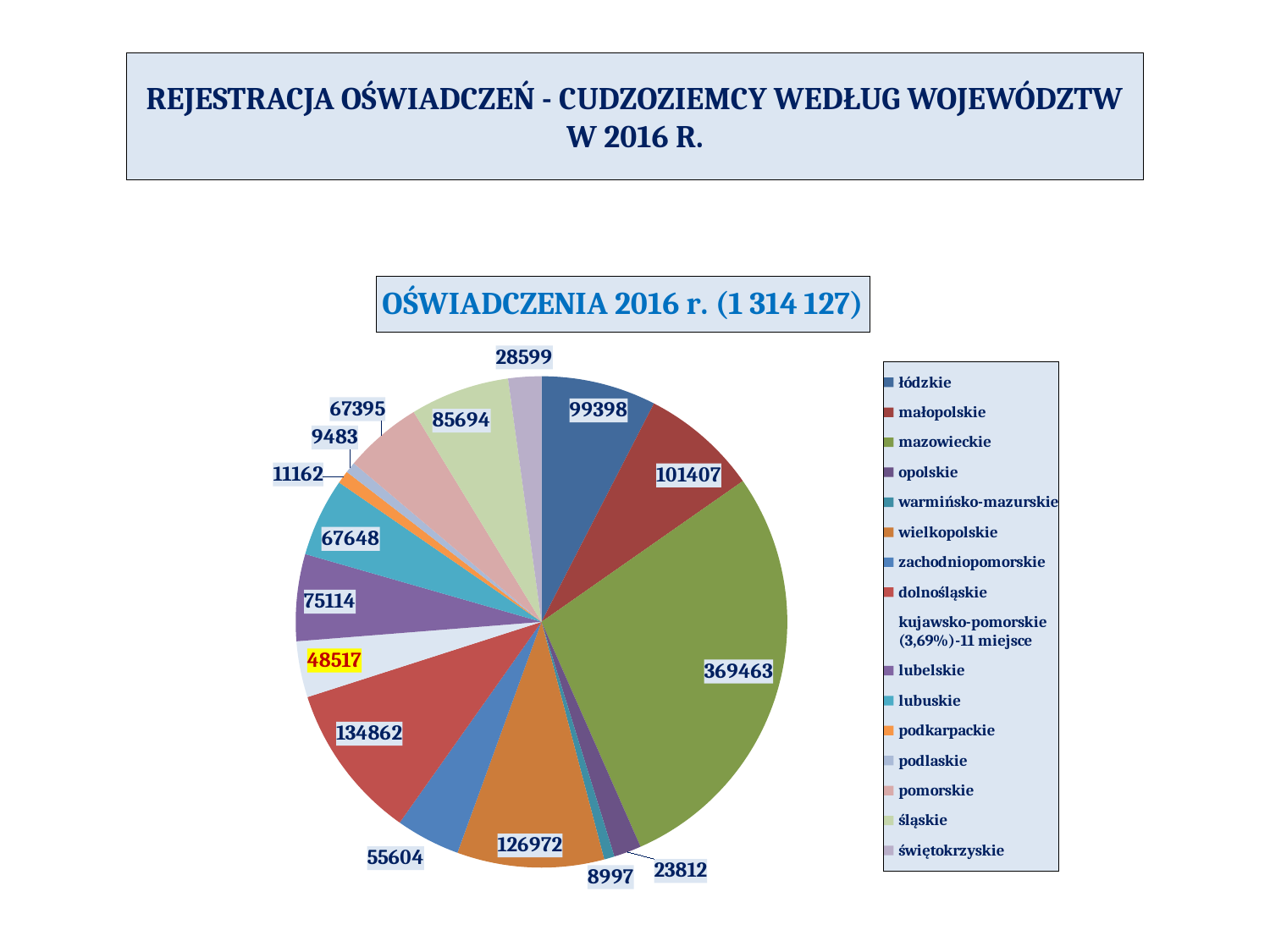
What type of chart is shown on the slide? pie chart Which voivodeship has the largest slice of the pie chart? mazowieckie What value is shown for mazowieckie in the pie chart? 369463 What is the difference between the values for dolnośląskie and wielkopolskie? 7890 Which voivodeship has the smallest slice of the pie chart? warmińsko-mazurskie What value is shown for śląskie in the pie chart? 85694 What share of the pie does kujawsko-pomorskie represent, according to the legend? 3,69% Which is larger, the value for dolnośląskie or the value for wielkopolskie? dolnośląskie What value is shown for lubelskie in the pie chart? 75114 How many voivodeships (slices) are shown in the pie chart? 16 What is the difference between the values for małopolskie and łódzkie? 2009 What total is given in the chart title? 1 314 127